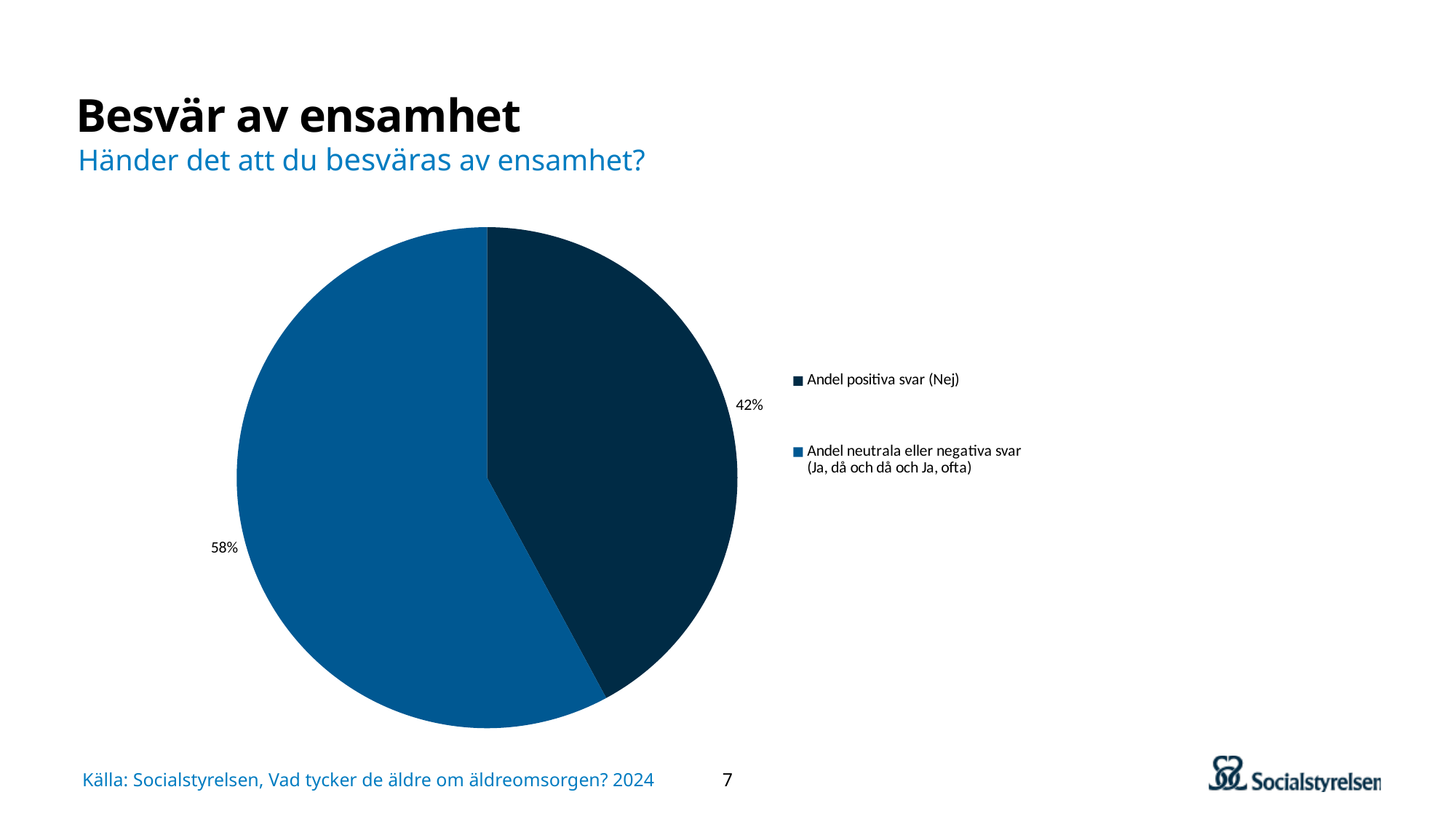
How many entries does the legend list? 2 What share of the pie is labelled "Andel neutrala eller negativa svar (Ja, då och då och Ja, ofta)"? 58% Which slice of the pie is the largest? Andel neutrala eller negativa svar (Ja, då och då och Ja, ofta) Which slice of the pie is the smallest? Andel positiva svar (Nej) What share of the pie is labelled "Andel positiva svar (Nej)"? 42% Which is larger: the share for "Andel positiva svar (Nej)" or the share for "Andel neutrala eller negativa svar"? Andel neutrala eller negativa svar How many slices does the pie chart have? 2 Is the share for "Andel positiva svar (Nej)" greater or less than 50%? less What is the title of the slide containing the pie chart? Besvär av ensamhet What kind of chart is shown on the slide? pie chart What is the difference in percentage points between the two slices of the pie? 16 What question is shown as the subtitle above the pie chart? Händer det att du besväras av ensamhet?